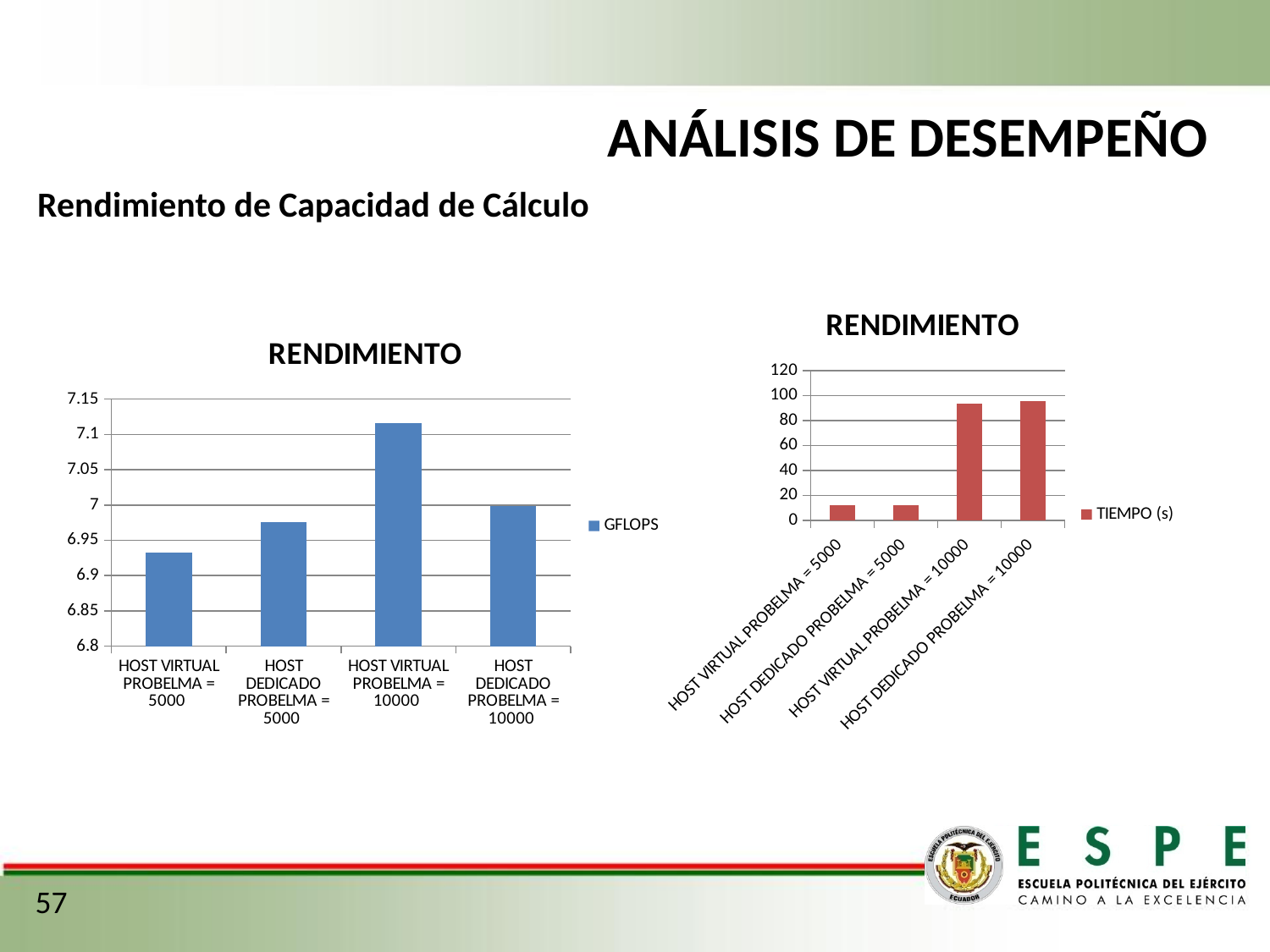
In the right chart, which is larger: the TIEMPO (s) value for HOST VIRTUAL PROBELMA = 5000 or for HOST VIRTUAL PROBELMA = 10000? HOST VIRTUAL PROBELMA = 10000 In the left chart, which category has the lowest GFLOPS value? HOST VIRTUAL PROBELMA = 5000 In the left chart, which is larger: the GFLOPS value for HOST DEDICADO PROBELMA = 5000 or for HOST VIRTUAL PROBELMA = 10000? HOST VIRTUAL PROBELMA = 10000 In the right chart, is the TIEMPO (s) value for HOST DEDICADO PROBELMA = 10000 greater or less than 80? greater In the left chart, is the GFLOPS value for HOST VIRTUAL PROBELMA = 10000 greater or less than 7? greater In the left chart, which category has the highest GFLOPS value? HOST VIRTUAL PROBELMA = 10000 In the right chart, is the TIEMPO (s) value for HOST VIRTUAL PROBELMA = 5000 greater or less than 20? less What kind of chart is the left chart on the slide? bar chart How many categories does the left chart show? 4 What series name appears in the legend of the right chart? TIEMPO (s) How many series does the legend of the left chart list? 1